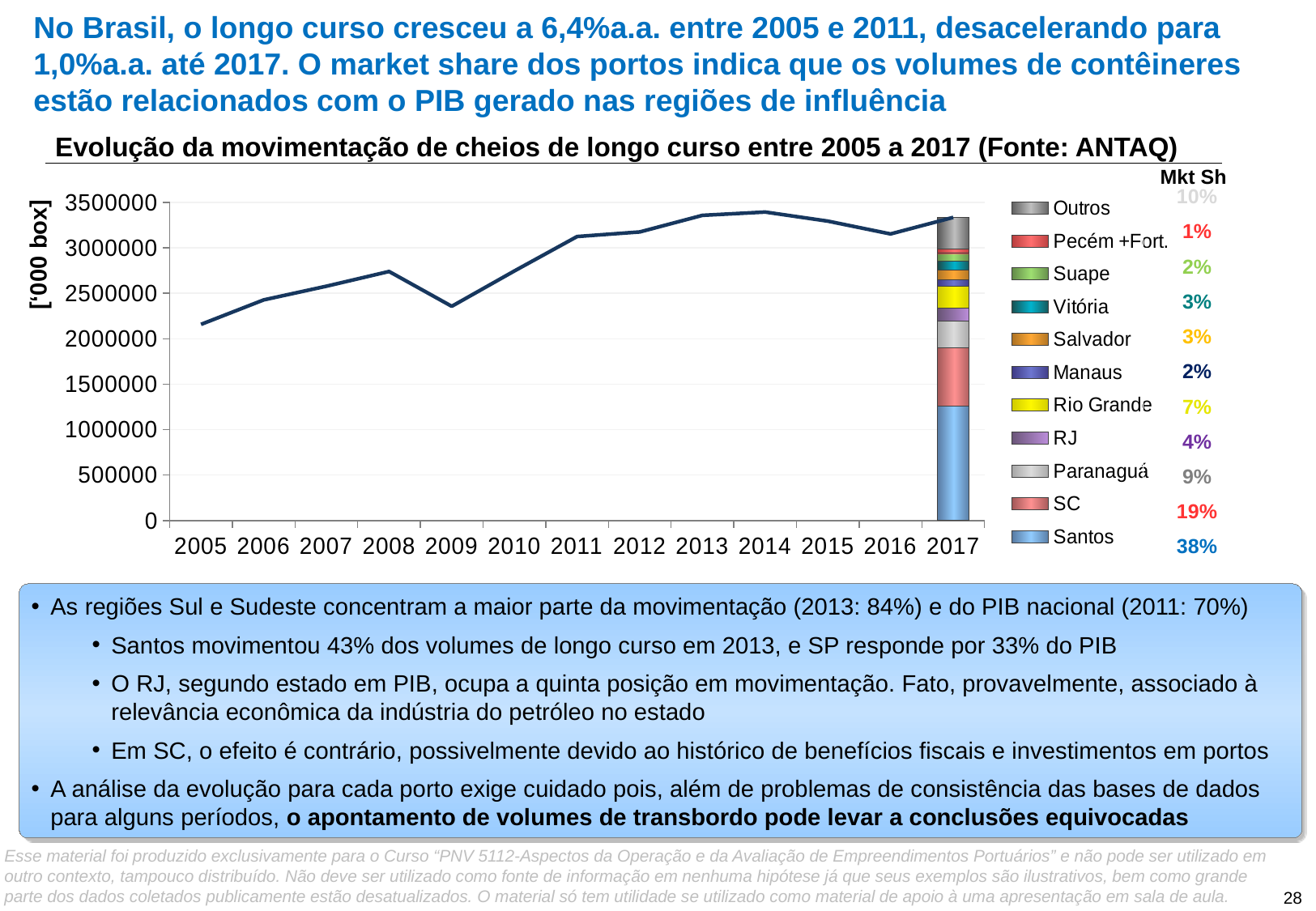
Does the line rise or fall between 2008 and 2009? fall How many entries does the chart's legend list? 11 Is the value of the line for 2014 greater or less than 3000000? greater Which has a larger market share, Rio Grande or RJ? Rio Grande Is the value of the line for 2005 greater or less than 2500000? less Which port has the highest market share in the 2017 stacked bar? Santos How many years are shown on the x axis of the chart? 13 What is the market share shown for Santos in the chart's legend? 38% What is the difference between the market shares of Santos and SC? 19% What market share is shown for Paranaguá? 9% What is the market share shown for SC (Santa Catarina) in the chart? 19% Which port has the lowest market share in the 2017 stacked bar? Pecém +Fort.